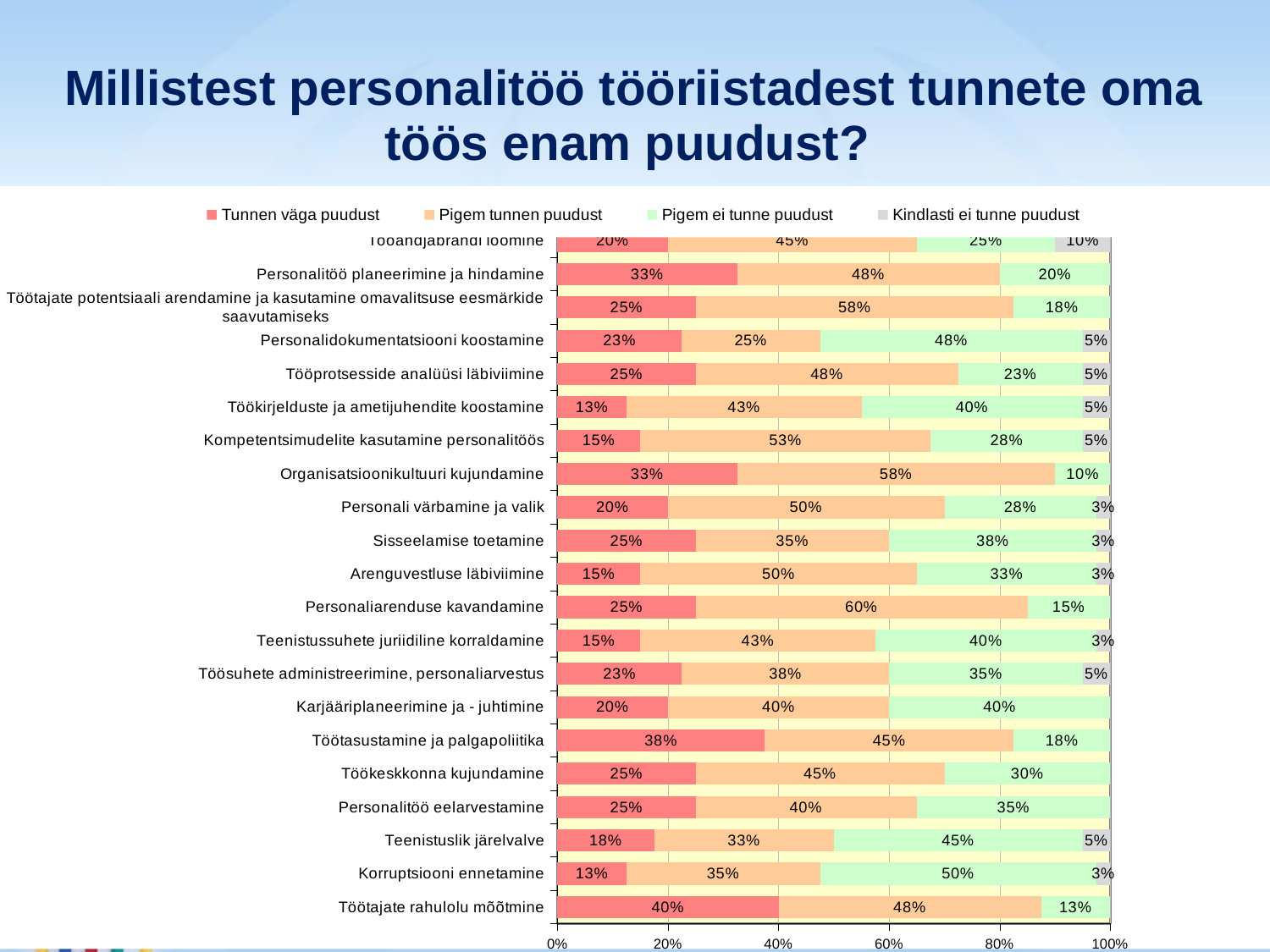
What is the 'Pigem tunnen puudust' value for Personaliarenduse kavandamine? 60% Which legend entry is shown in red? Tunnen väga puudust Which is larger: the 'Pigem ei tunne puudust' value for Personalidokumentatsiooni koostamine or for Tööprotsesside analüüsi läbiviimine? Personalidokumentatsiooni koostamine What is the 'Kindlasti ei tunne puudust' value for Tööandjabrändi loomine? 10% Which category has the highest 'Pigem tunnen puudust' value? Personaliarenduse kavandamine How many series does the legend list? 4 What kind of chart is shown on the slide? stacked bar chart What is the 'Tunnen väga puudust' value for Töötajate rahulolu mõõtmine? 40% What is the difference between the 'Tunnen väga puudust' values for Töötasustamine ja palgapoliitika and Teenistuslik järelvalve? 20% Which category has the highest 'Tunnen väga puudust' value? Töötajate rahulolu mõõtmine What is the 'Pigem ei tunne puudust' value for Korruptsiooni ennetamine? 50% How many categories are plotted on the chart? 21